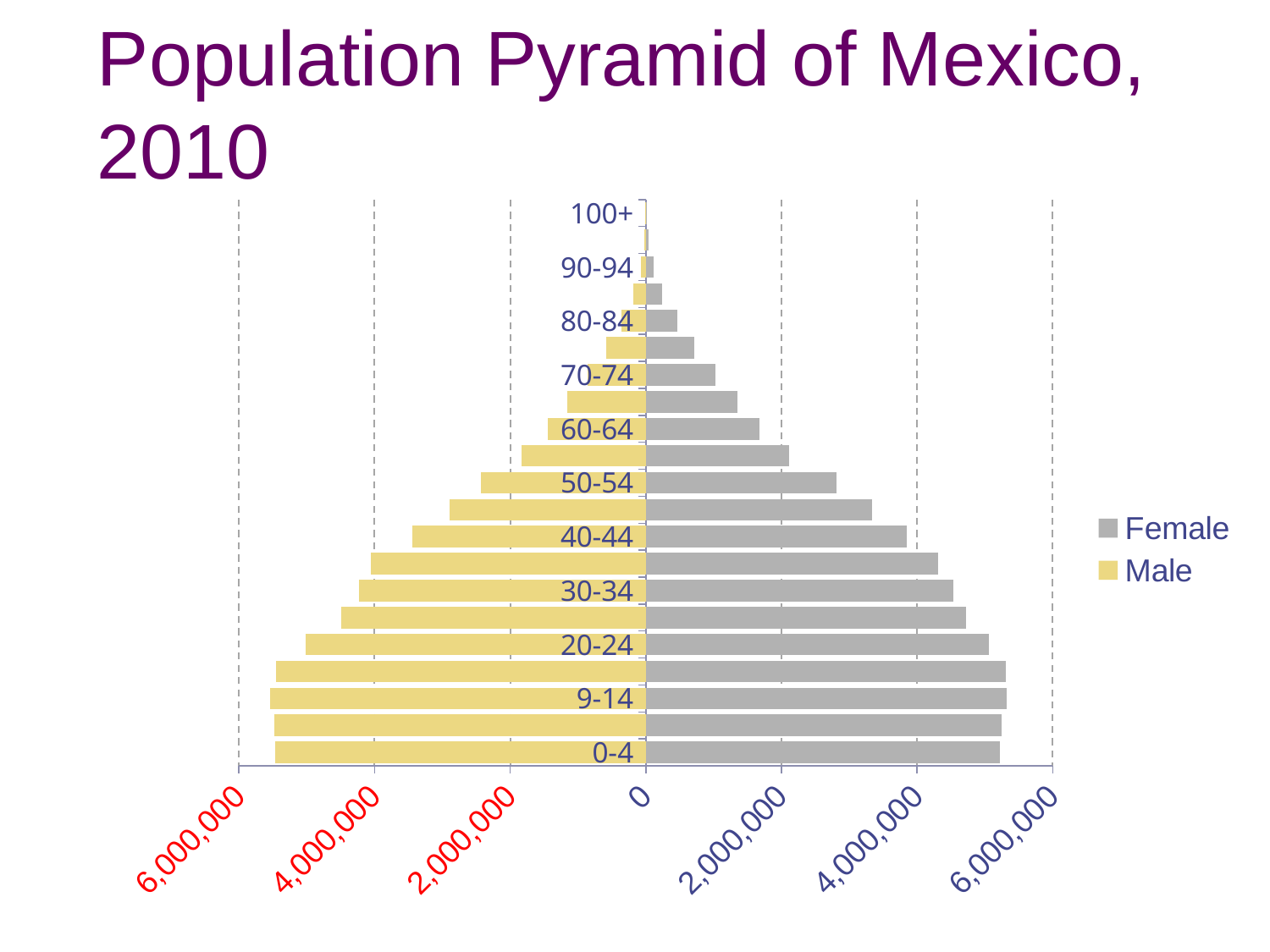
Is the Male value for the 0-4 age group greater or less than 4,000,000? greater Which age group has the smallest Male value? 100+ Do the Female values rise or fall as the age group increases from 20-24 to 100+? fall What is the title of the chart? Population Pyramid of Mexico, 2010 Which is larger, the Male value for 0-4 or the Male value for 50-54? 0-4 Is the Male value for the 60-64 age group greater or less than 2,000,000? less What kind of chart is shown on the slide? bar chart Which colour represents the Male series in the legend? yellow Which is larger, the Female value for 20-24 or the Female value for 60-64? 20-24 Is the Female value for the 50-54 age group greater or less than 4,000,000? less How many series does the legend list? 2